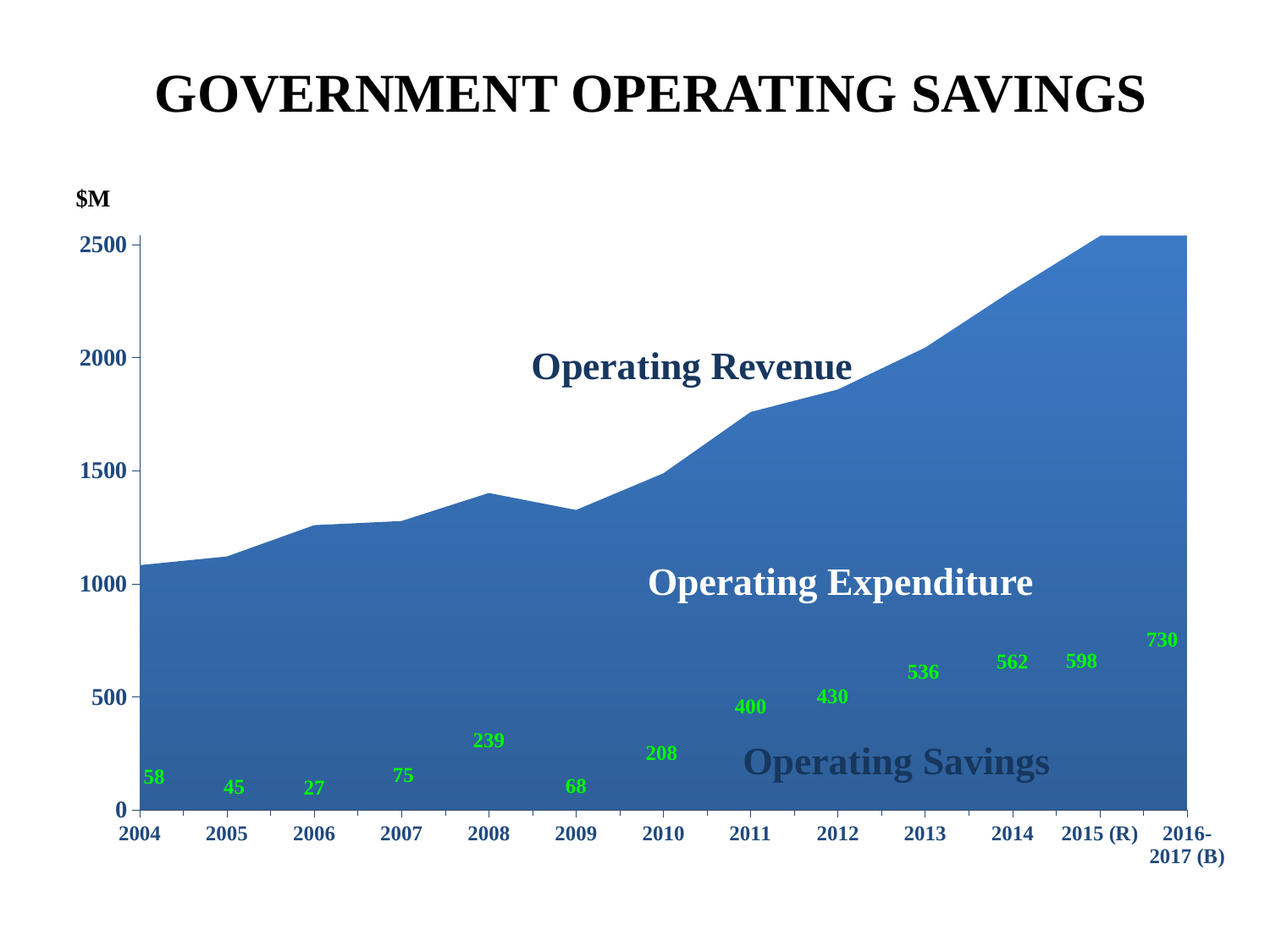
Which year has the larger Operating Savings value, 2010 or 2011? 2011 How many years are shown on the x axis? 13 What is the difference between the Operating Savings values for 2008 and 2009? 171 Is the Operating Revenue value for 2009 greater or less than 1500? less What is the Operating Savings value for 2008? 239 What unit is shown on the y axis of the chart? $M Which year has the lowest Operating Savings value? 2006 What is the Operating Savings value for 2013? 536 What kind of chart is shown on the slide? Area chart Which year has the highest Operating Savings value? 2016-2017 (B) What is the difference between the Operating Savings values for 2015 (R) and 2014? 36 What is the Operating Savings value for 2016-2017 (B)? 730